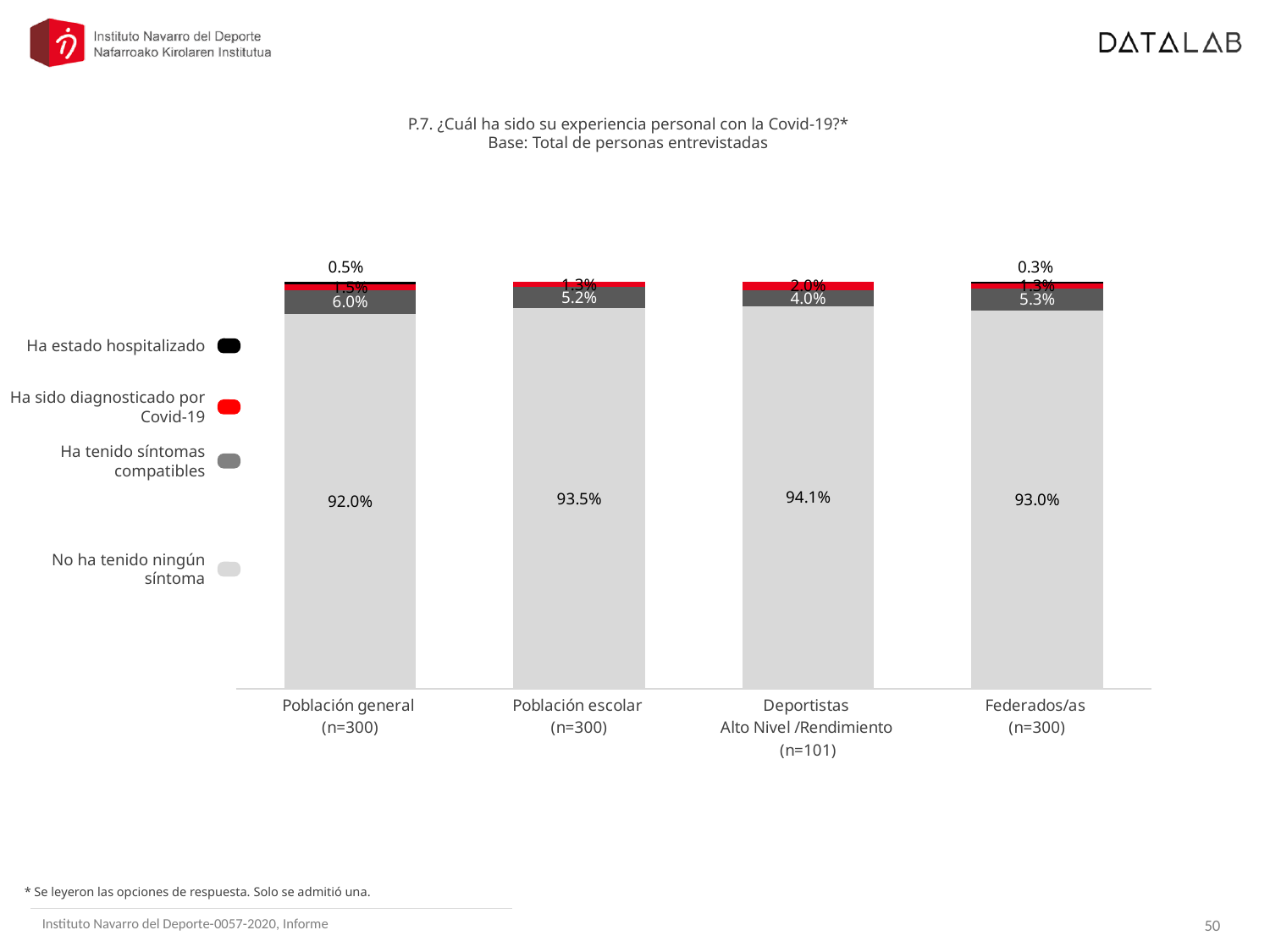
What is the difference in 'Ha tenido síntomas compatibles' between Población general (6.0%) and Deportistas Alto Nivel/Rendimiento (4.0%)? 2.0 percentage points Which is larger for 'No ha tenido ningún síntoma': Población escolar or Federados/as? Población escolar How many population groups (categories) are shown along the x axis? 4 What percentage of Federados/as reported 'Ha estado hospitalizado'? 0.3% How many series does the legend list? 4 What kind of chart is shown on the slide? Stacked bar chart Which group has the highest share of 'No ha tenido ningún síntoma'? Deportistas Alto Nivel/Rendimiento Which group has the lowest share of 'No ha tenido ningún síntoma'? Población general What is the value of 'No ha tenido ningún síntoma' for Deportistas Alto Nivel/Rendimiento (n=101)? 94.1% What percentage of Población general (n=300) reported 'No ha tenido ningún síntoma'? 92.0% What colour represents 'Ha sido diagnosticado por Covid-19' in the legend? Red What is the value of 'Ha tenido síntomas compatibles' for Población escolar? 5.2%